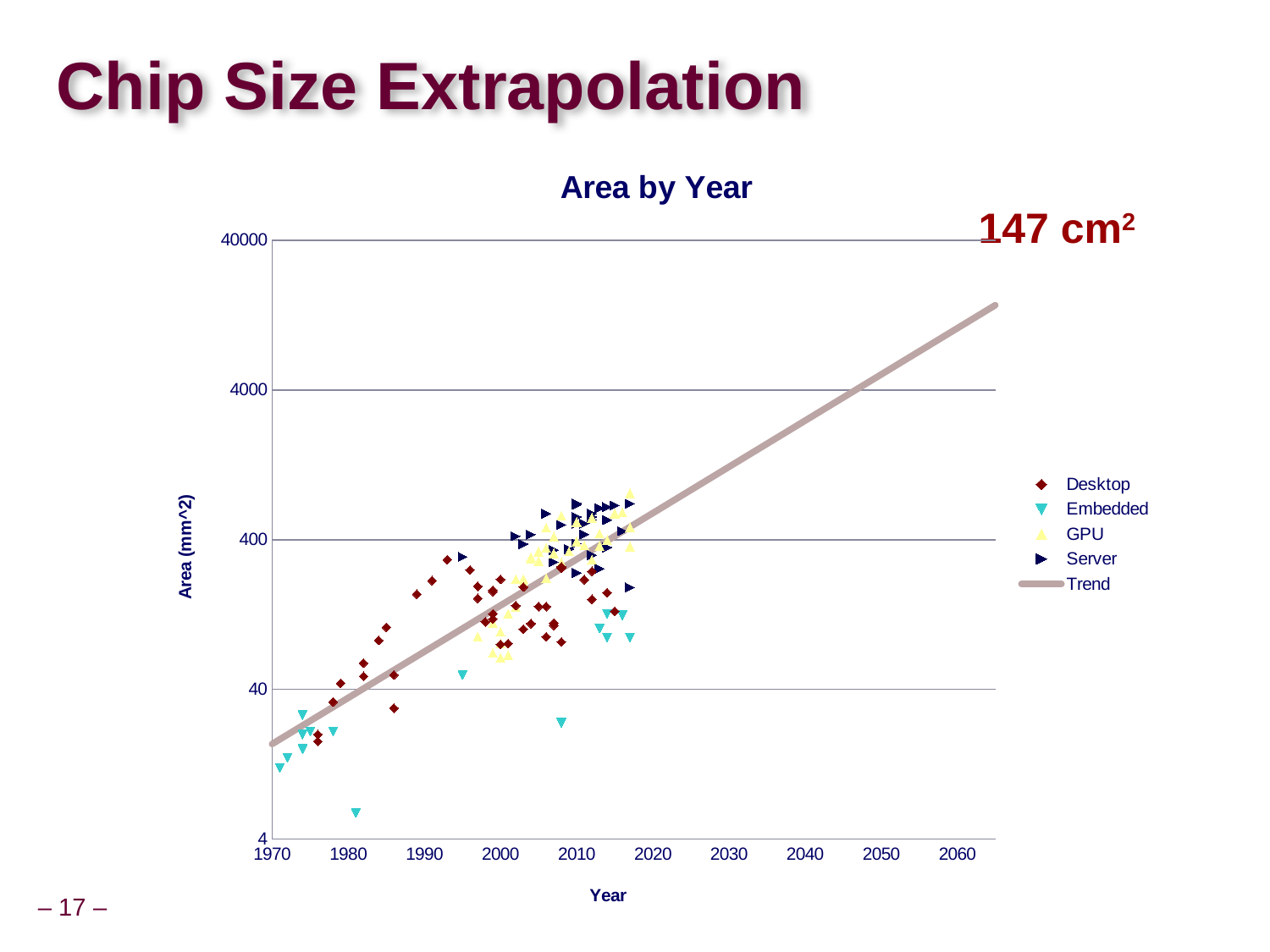
Which series has the lowest plotted point on the chart? Embedded How many entries does the chart's legend list? 5 Is the lowest Embedded value greater or less than 40? less How many tick labels are shown on the x axis? 10 What is the first year label on the x axis? 1970 What is the title of the chart? Area by Year Is the value of the Trend line at 2060 greater or less than 4000? greater Does the Trend line rise or fall as the year increases? rises What kind of chart is shown on the slide? scatter chart Is the highest Server value greater or less than 400? greater What is the label of the y axis? Area (mm^2)